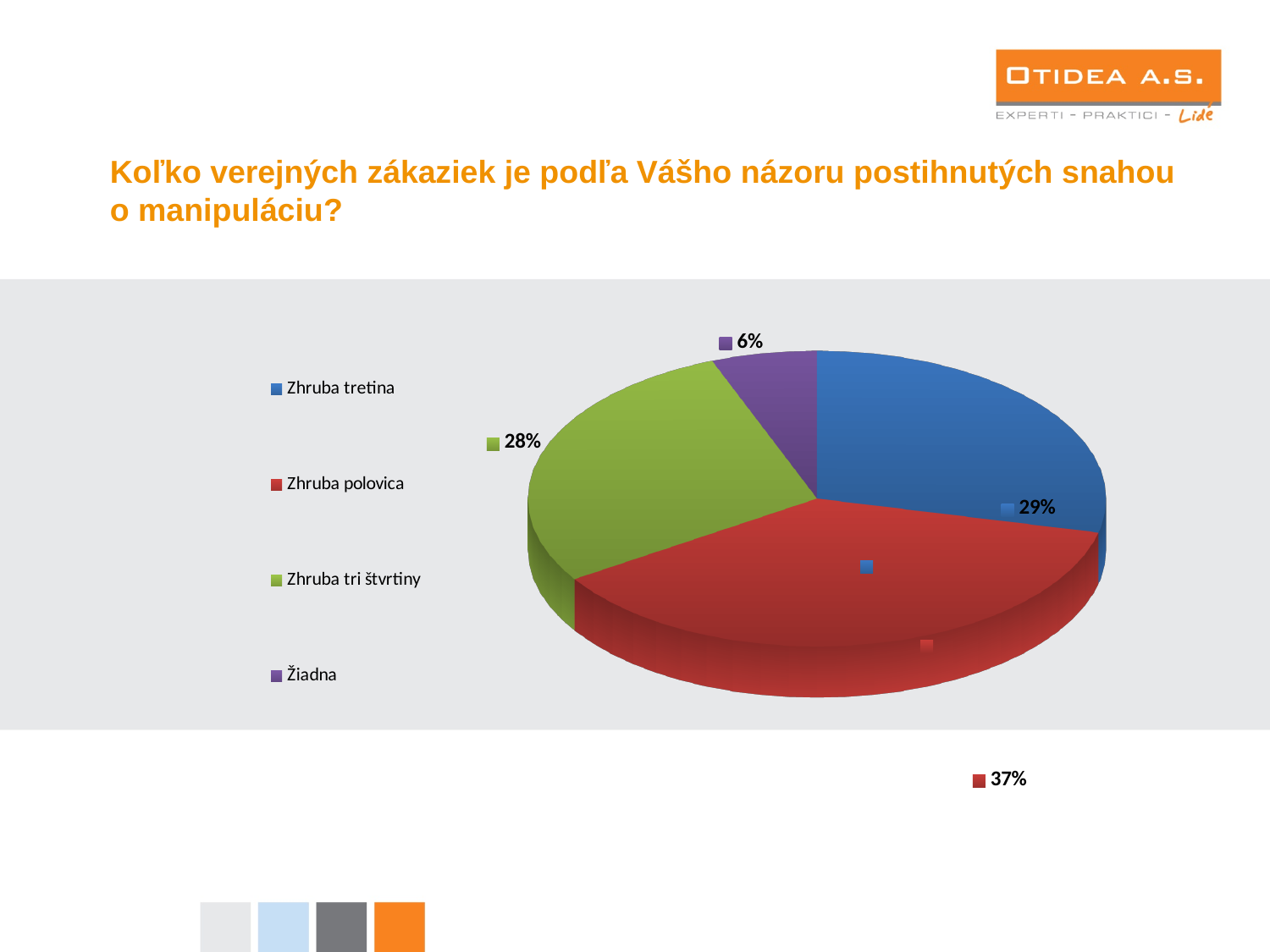
What colour is the slice for "Žiadna"? purple What share of the pie does "Zhruba polovica" have? 37% What is the difference in percentage points between "Zhruba tretina" and "Žiadna"? 23 What is the difference in percentage points between "Zhruba polovica" and "Zhruba tretina"? 8 Which category has the largest slice of the pie? Zhruba polovica Which is larger, the slice for "Zhruba polovica" or the slice for "Zhruba tri štvrtiny"? Zhruba polovica What share of the pie does "Žiadna" have? 6% Which category has the smallest slice of the pie? Žiadna How many categories does the pie chart have? 4 What share of the pie does "Zhruba tretina" have? 29% What kind of chart is shown on the slide? pie chart What share of the pie does "Zhruba tri štvrtiny" have? 28%